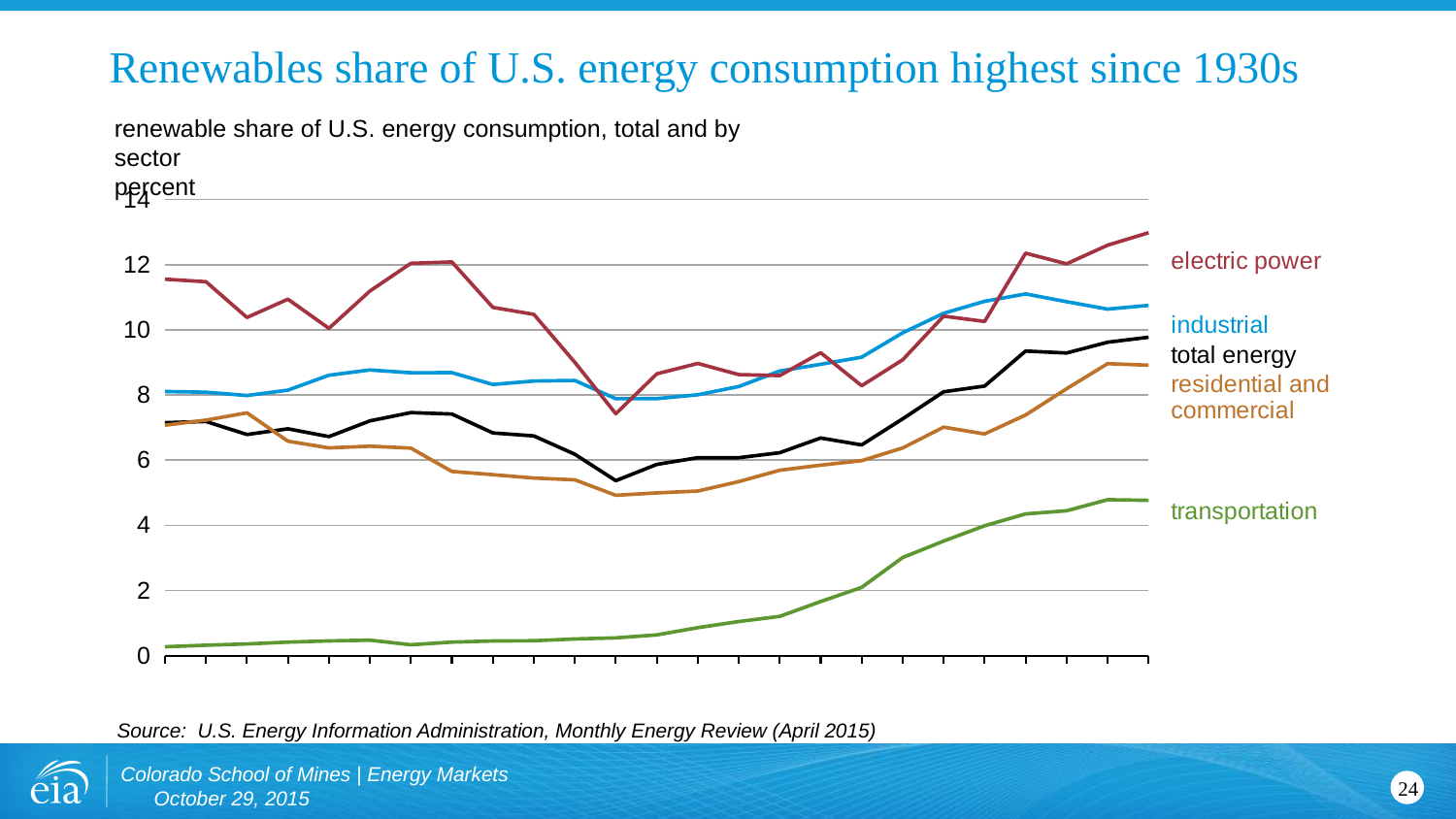
How many series are plotted on the chart? 5 What is the title of the slide? Renewables share of U.S. energy consumption highest since 1930s Does the transportation series rise or fall from left to right across the chart? rise At the right end of the chart, is the value for industrial greater or less than 10? greater At the right end of the chart, is the value for total energy greater or less than 10? less At the right end of the chart, which is larger: industrial or residential and commercial? industrial Which series has the highest value at the right end of the chart? electric power What kind of chart is shown on the slide? line chart At the right end of the chart, is the value for electric power greater or less than 12? greater Which series has the lowest value across the whole chart? transportation What unit is the vertical axis measured in? percent